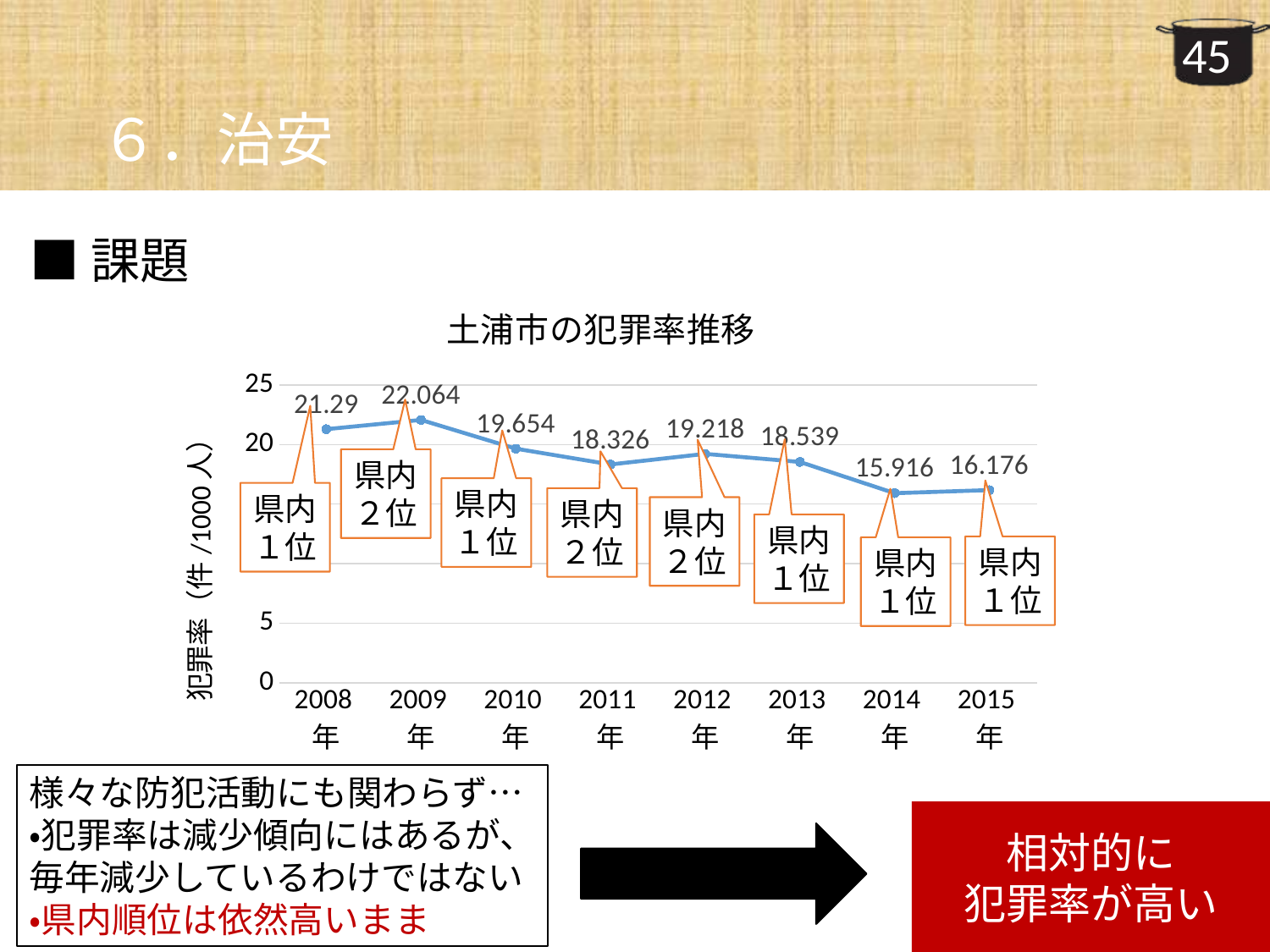
What kind of chart is used to show 土浦市の犯罪率推移? line chart How many years are plotted on the x axis of the chart? 8 Which year has the highest crime rate in the chart? 2009年 Is the crime rate for 2010年 greater or less than 20? less What is the crime rate value shown for 2009年 in the chart? 22.064 What is the crime rate value shown for 2014年? 15.916 Which is larger, the crime rate in 2012年 or in 2013年? 2012年 What is the crime rate value shown for 2011年? 18.326 Which year has the lowest crime rate in the chart? 2014年 What is the difference between the crime rate in 2009年 and in 2015年? 5.888 Overall, does the crime rate rise or fall from 2008年 to 2015年? fall What is the title of the chart on the slide? 土浦市の犯罪率推移